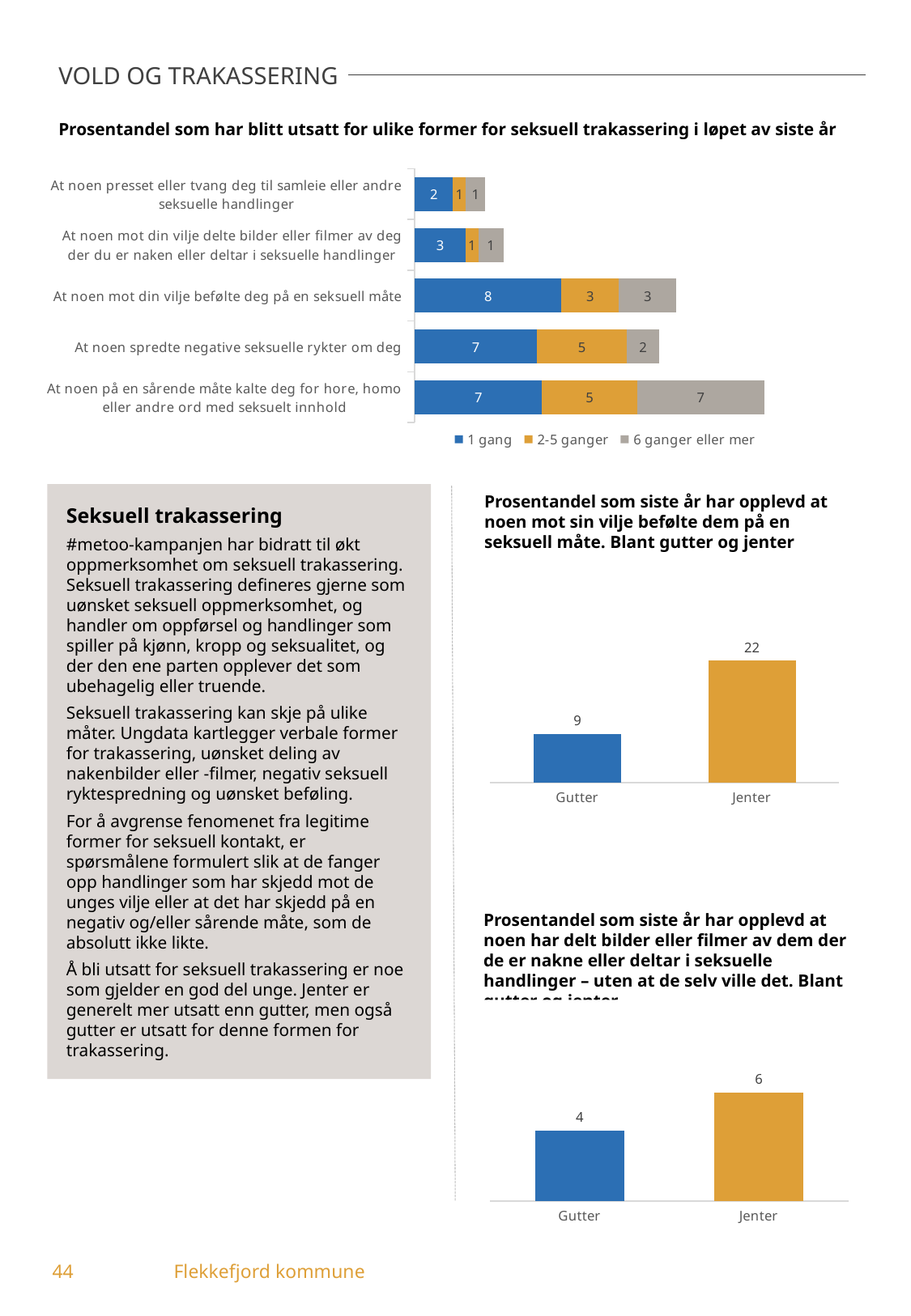
In the top stacked bar chart, which category has the largest total? At noen på en sårende måte kalte deg for hore, homo eller andre ord med seksuelt innhold In the top stacked bar chart, what is the value for '6 ganger eller mer' for 'At noen på en sårende måte kalte deg for hore, homo eller andre ord med seksuelt innhold'? 7 In the top stacked bar chart, what is the value for '1 gang' for 'At noen mot din vilje befølte deg på en seksuell måte'? 8 What kind of chart is the bottom chart about delte bilder eller filmer? Bar chart How many categories are shown in the top stacked bar chart? 5 In the chart titled 'Prosentandel som siste år har opplevd at noen mot sin vilje befølte dem på en seksuell måte', what is the value for Jenter? 22 In the top stacked bar chart, what is the total of the stacked bar for 'At noen spredte negative seksuelle rykter om deg'? 14 In the bottom chart about delte bilder eller filmer, what is the value for Gutter? 4 In the top stacked bar chart, what is the total of the stacked bar for 'At noen presset eller tvang deg til samleie eller andre seksuelle handlinger'? 4 In the chart titled 'Prosentandel som siste år har opplevd at noen mot sin vilje befølte dem på en seksuell måte', what is the difference between Jenter and Gutter? 13 How many series does the legend of the top stacked bar chart list? 3 In the bottom chart about delte bilder eller filmer, which is larger, Gutter or Jenter? Jenter